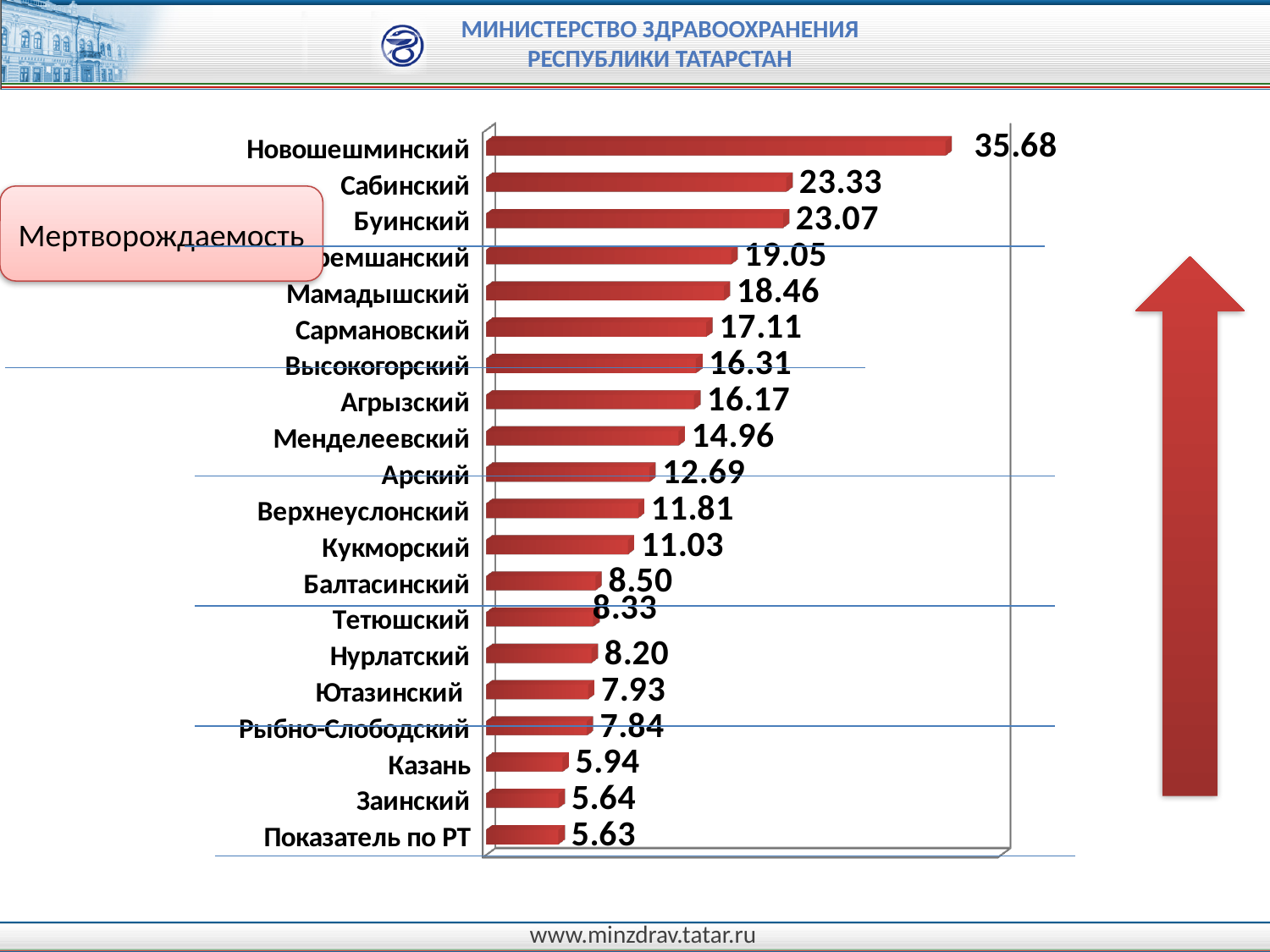
How many categories are shown in the chart? 20 What is the title shown in the box next to the chart? Мертворождаемость Which is larger, the value for Мамадышский or the value for Сармановский? Мамадышский What is the difference between the values for Новошешминский and Показатель по РТ? 30.05 Which category has the highest value? Новошешминский What is the difference between the values for Сабинский and Буинский? 0.26 What is the value for Казань? 5.94 What is the value for Показатель по РТ? 5.63 What is the value for Арский? 12.69 Which category has the lowest value? Показатель по РТ What is the value for Новошешминский? 35.68 What kind of chart is shown on the slide? Bar chart